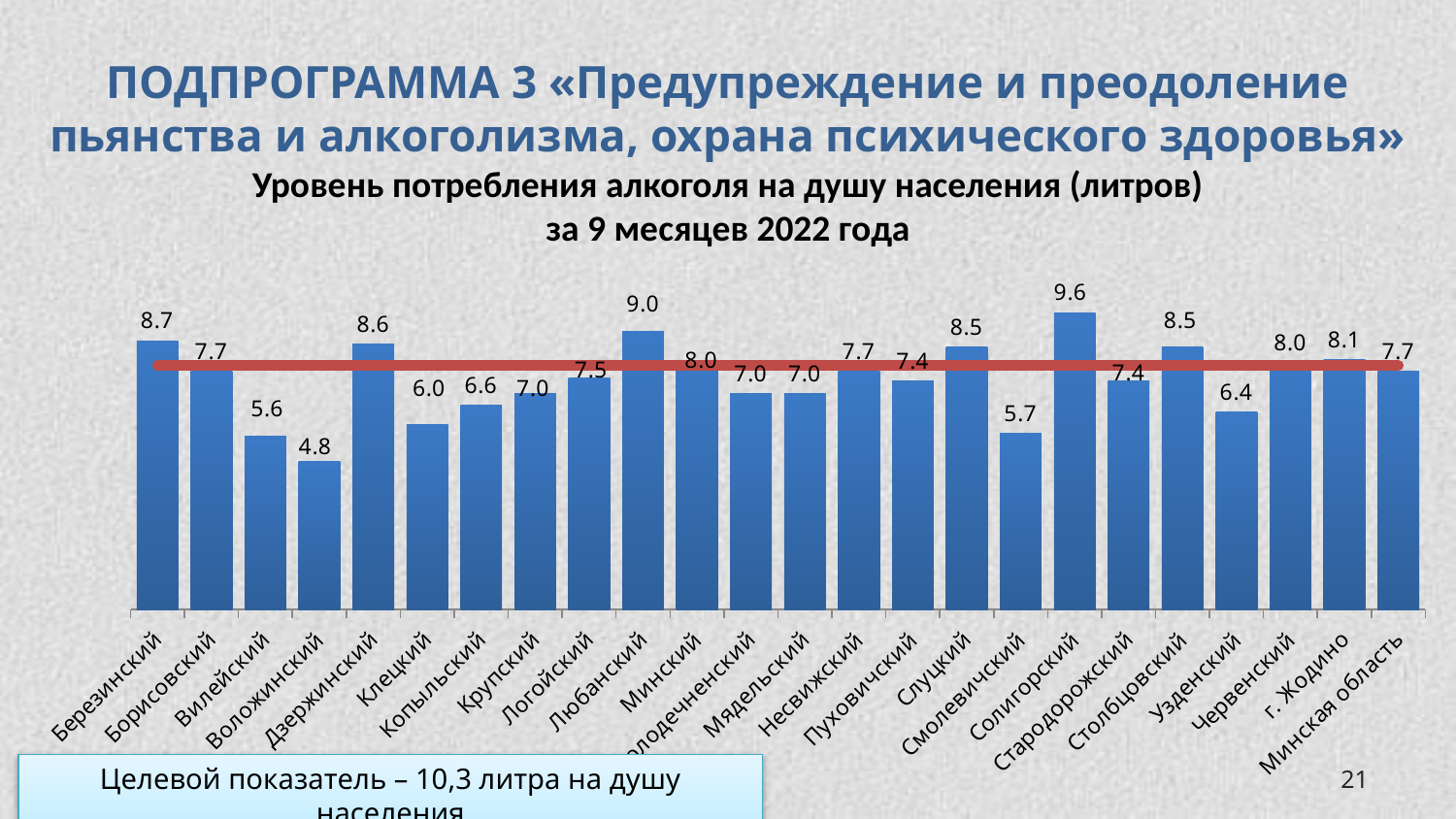
Which district has the lowest value on the chart? Воложинский What value is shown for Воложинский? 4.8 What value is shown for Минская область? 7.7 What type of chart is shown on the slide? Bar chart with a horizontal line (combination bar and line chart) What is the difference between the values for Солигорский and Воложинский? 4.8 What value is shown for г. Жодино? 8.1 Which has a larger value, Узденский or Смолевичский? Узденский Which has a larger value, Любанский or Дзержинский? Любанский Which district has the highest value on the chart? Солигорский What is the difference between the values for Березинский and Борисовский? 1.0 How many categories (bars) are shown on the chart? 24 What is the alcohol consumption value shown for Солигорский? 9.6